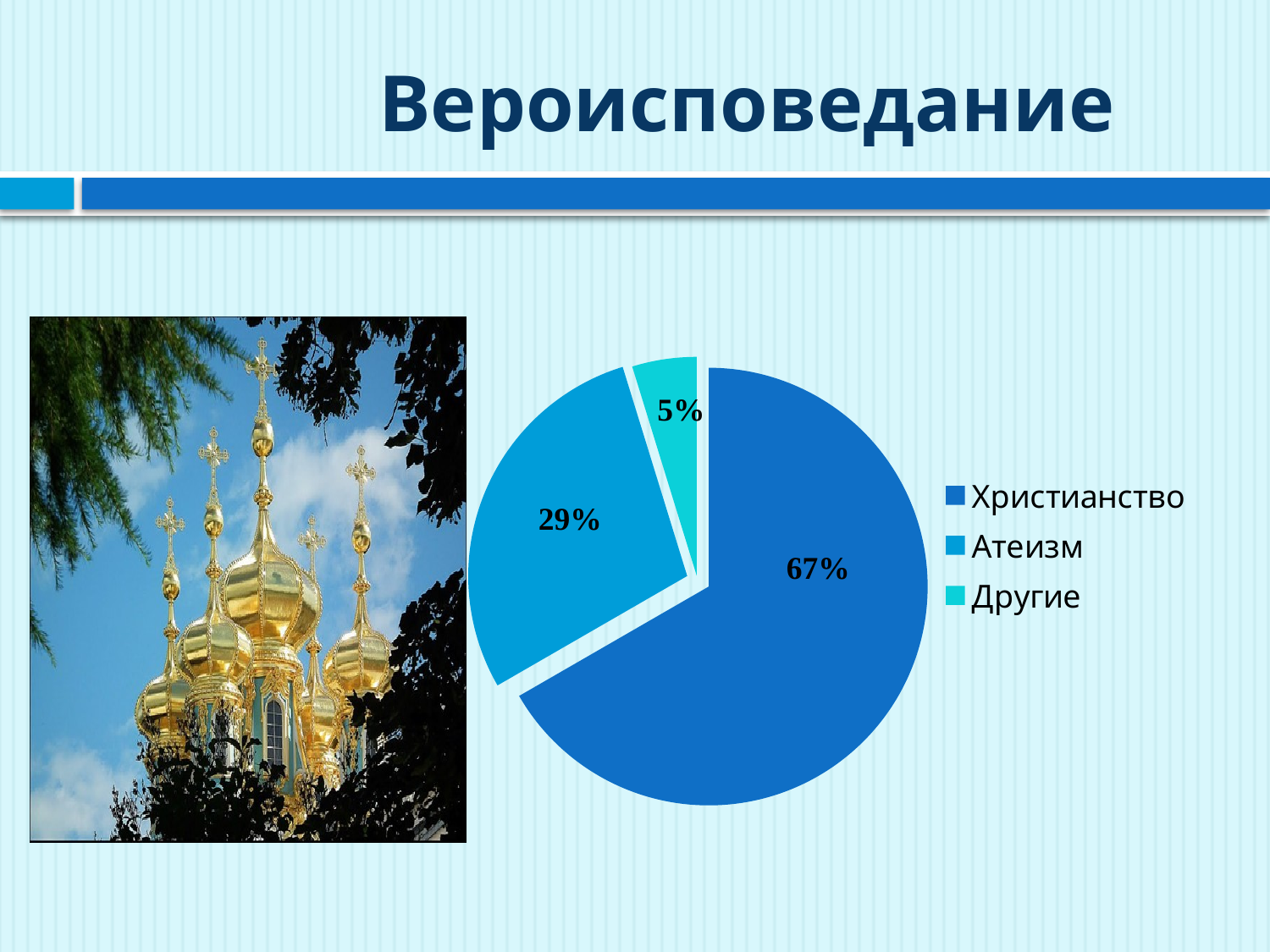
What is the title of the slide containing the pie chart? Вероисповедание What share of the pie does Атеизм have? 29% Which category has the smallest slice of the pie? Другие Which legend entry is listed first? Христианство What is the difference between the shares of Христианство and Атеизм? 38% Which is larger, the share of Атеизм or the share of Другие? Атеизм What share of the pie does Другие have? 5% Which category has the largest slice of the pie? Христианство What kind of chart is shown on the slide? pie chart How many categories does the pie chart have? 3 What is the difference between the shares of Атеизм and Другие? 24% What share of the pie does Христианство have? 67%